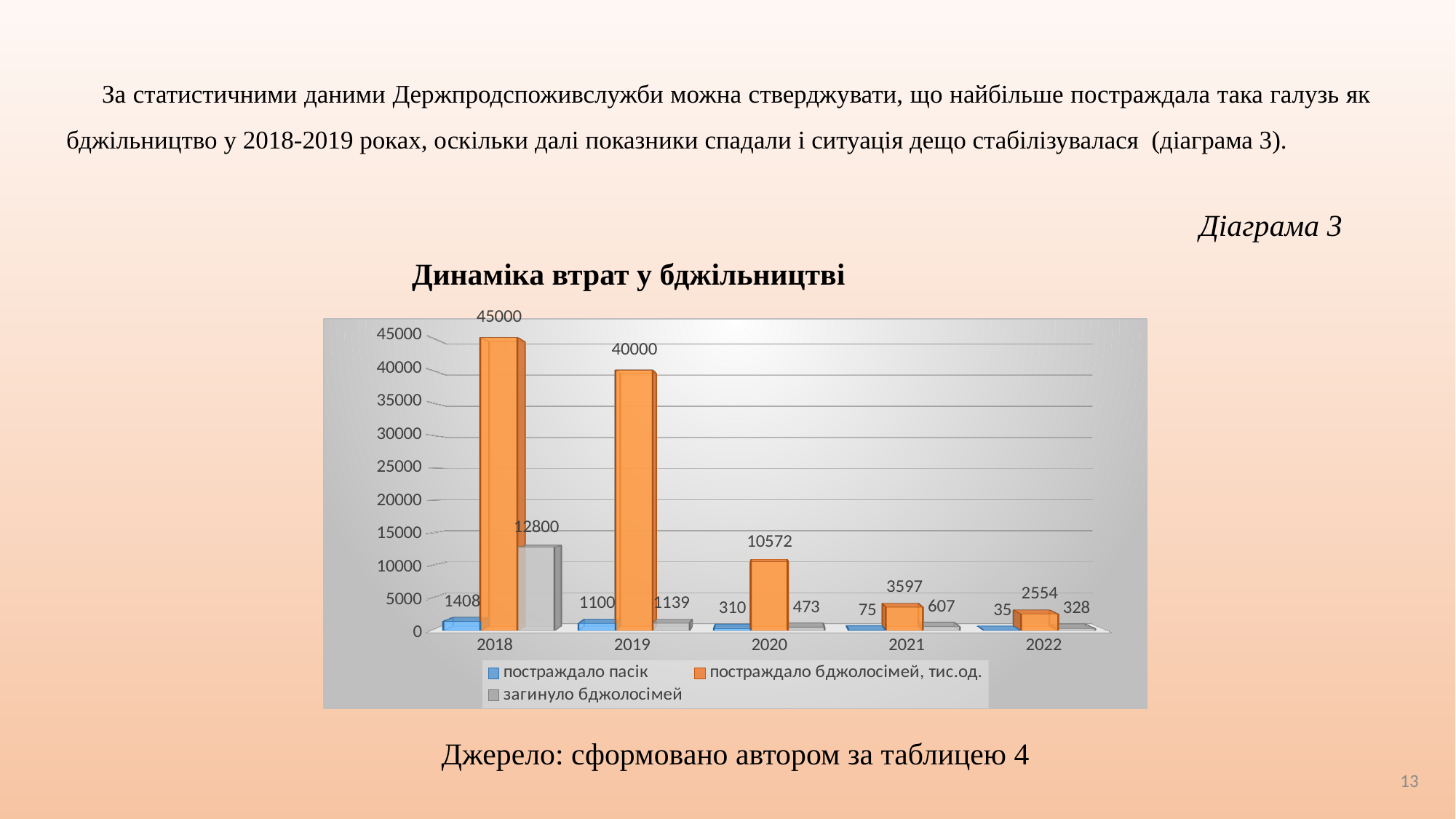
How many series does the chart legend list? 3 Which is larger: 'загинуло бджолосімей' in 2020 or in 2021? 2021 In which year is the value for 'загинуло бджолосімей' the highest? 2018 What is the value for 'постраждало бджолосімей, тис.од.' in 2018? 45000 What is the value for 'загинуло бджолосімей' in 2019? 1139 What type of chart is shown on the slide? Bar chart Does the value for 'постраждало пасік' rise or fall from 2018 to 2022? Fall What is the difference between the 'постраждало бджолосімей, тис.од.' values for 2018 and 2019? 5000 What is the value for 'постраждало пасік' in 2021? 75 What is the title of the chart? Динаміка втрат у бджільництві In which year is the value for 'постраждало бджолосімей, тис.од.' the lowest? 2022 How many years are shown on the x axis of the chart? 5